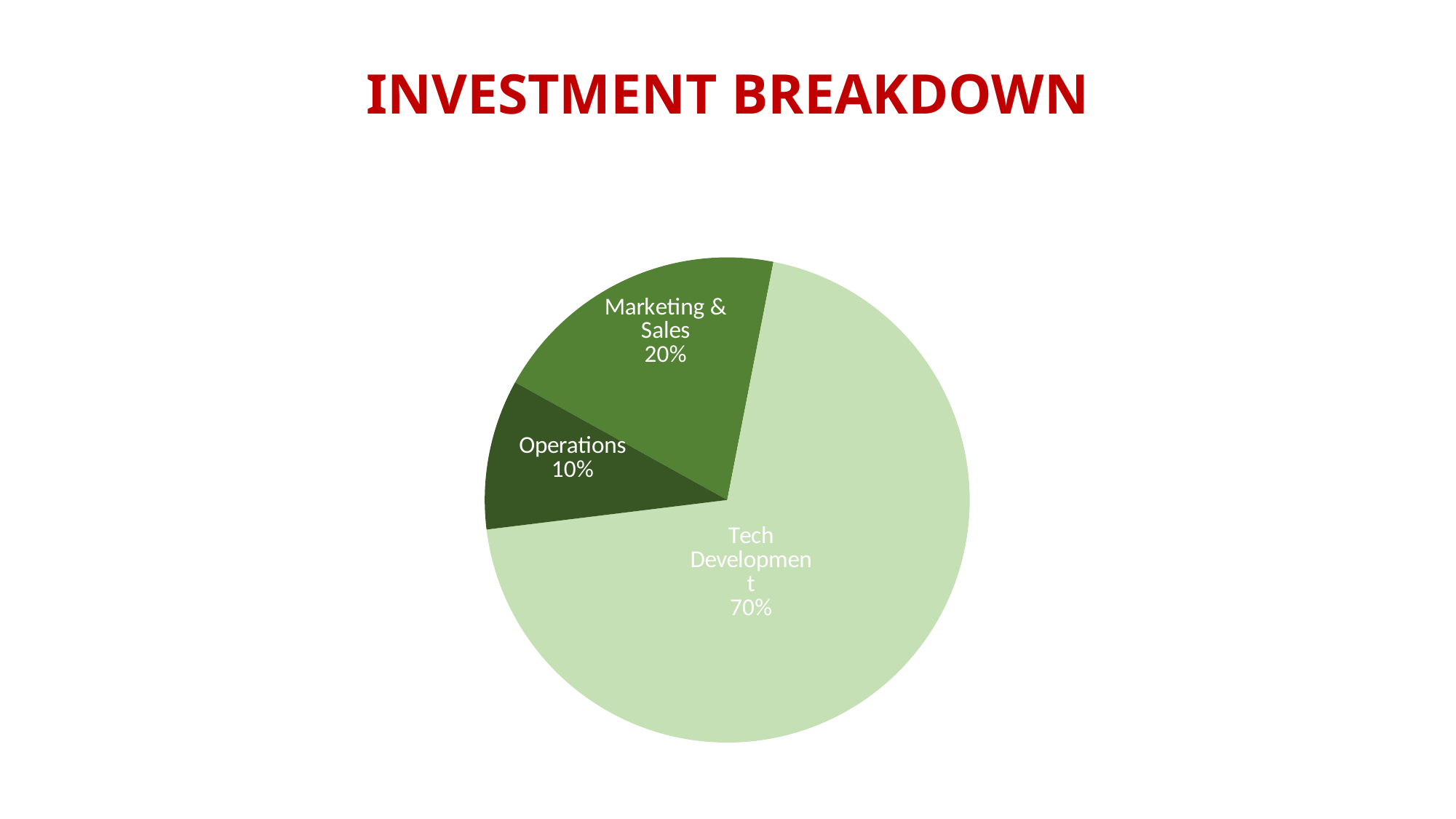
What share of the investment goes to Tech Development? 70% Which category has the largest share of the investment? Tech Development What is the difference in percentage points between Marketing & Sales and Operations? 10 Which is larger, the share for Marketing & Sales or the share for Operations? Marketing & Sales What share of the investment goes to Marketing & Sales? 20% Which slice of the pie is the lightest green? Tech Development What kind of chart is shown on the slide? Pie chart How many slices does the pie chart have? 3 Which category has the smallest share of the investment? Operations What is the title of the chart on the slide? INVESTMENT BREAKDOWN What is the difference in percentage points between Tech Development and Marketing & Sales? 50 What share of the investment goes to Operations? 10%